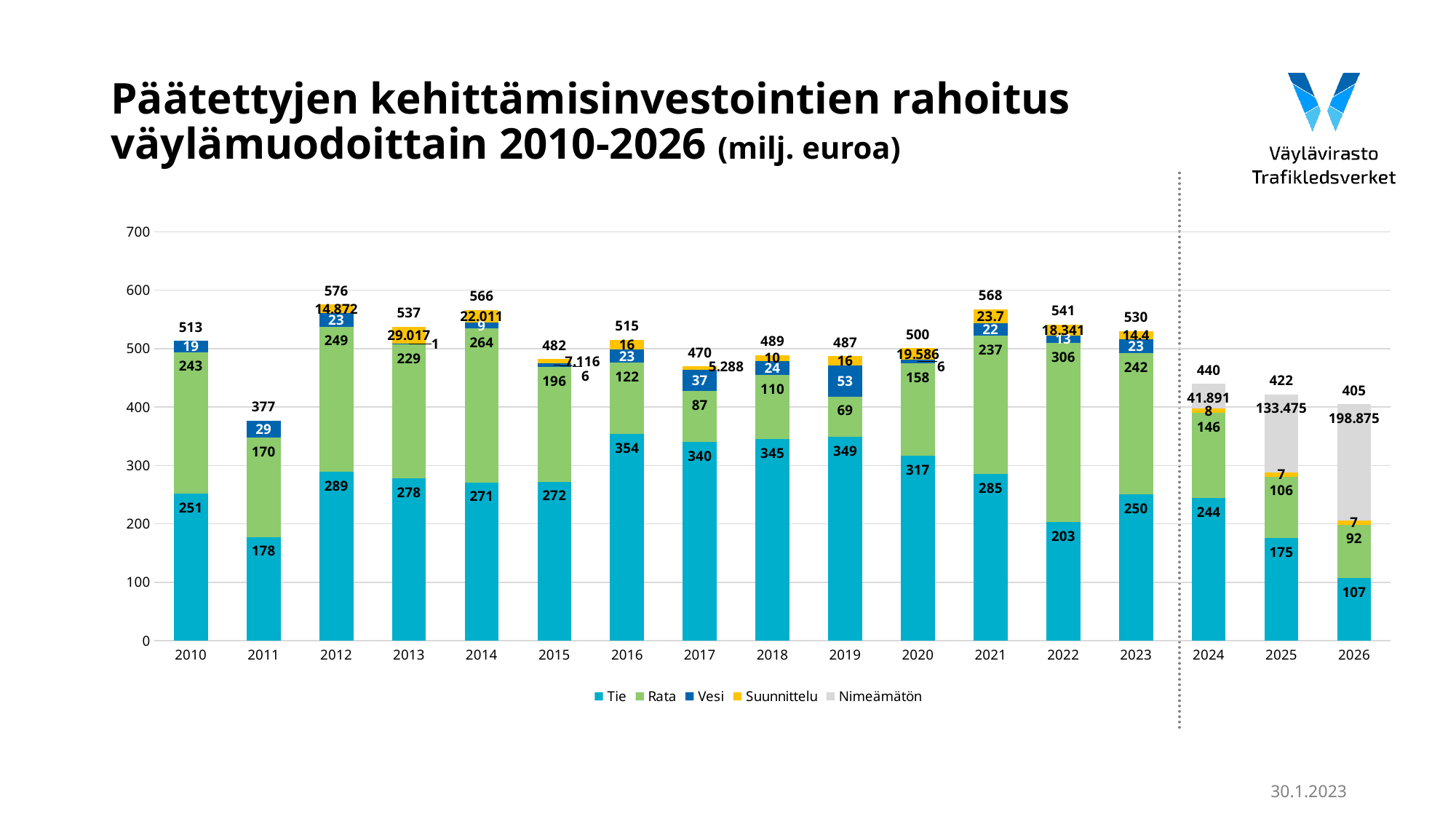
What is the value of the Tie series for 2016? 354 What is the total of the stacked bar for 2010? 513 Which year has the larger Rata value, 2012 or 2021? 2012 How many years are shown on the x axis? 17 Which year has the lowest total stacked bar? 2011 What is the value of the Rata series for 2022? 306 What is the value of the Nimeämätön series for 2026? 198.875 What is the difference between the Tie value for 2016 and the Tie value for 2011? 176 Which year has the highest total stacked bar? 2012 What is the value of the Vesi series for 2019? 53 How many series does the legend list? 5 What kind of chart is shown on the slide? Stacked bar chart